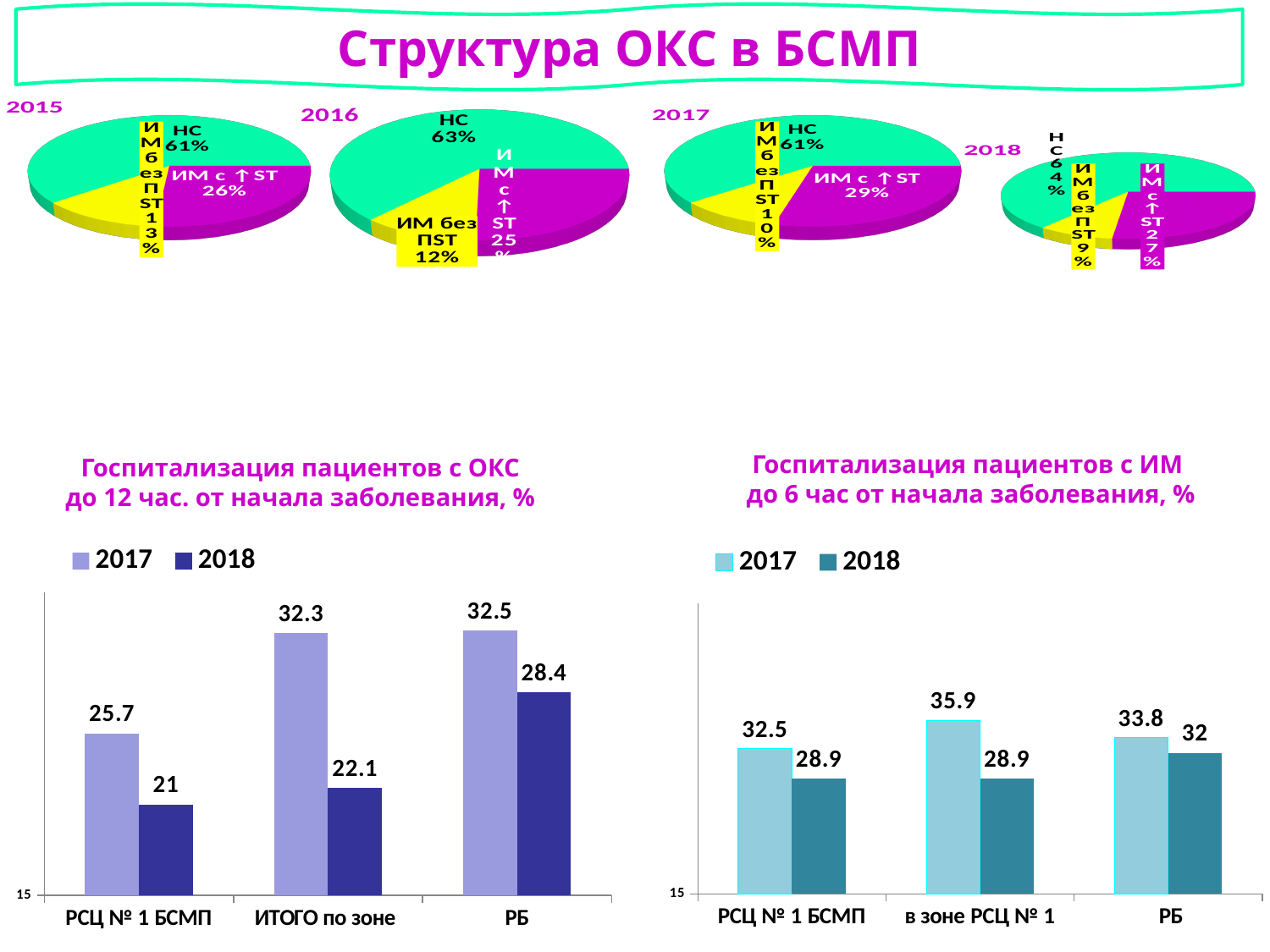
In the chart 'Госпитализация пациентов с ИМ до 6 час от начала заболевания, %', what is the 2017 value for в зоне РСЦ № 1? 35.9 In the 2015 pie chart, what share is labelled for НС? 61% In the 2015 pie chart, which slice is the smallest? ИМ без ПST In the 2018 pie chart, which slice is the largest? НС In the 2016 pie chart, what share is labelled for ИМ без ПST? 12% What type of chart is 'Госпитализация пациентов с ОКС до 12 час. от начала заболевания, %'? Bar chart In the chart 'Госпитализация пациентов с ИМ до 6 час от начала заболевания, %', which is larger: the 2018 value for РБ or the 2018 value for РСЦ № 1 БСМП? РБ In the 2017 pie chart, what share is labelled for ИМ с ↑ST? 29% In the chart 'Госпитализация пациентов с ОКС до 12 час. от начала заболевания, %', what is the difference between the 2017 and 2018 values for ИТОГО по зоне? 10.2 In the chart 'Госпитализация пациентов с ОКС до 12 час. от начала заболевания, %', what is the 2018 value for РСЦ № 1 БСМП? 21 How many series does the legend list in the chart 'Госпитализация пациентов с ИМ до 6 час от начала заболевания, %'? 2 In the chart 'Госпитализация пациентов с ОКС до 12 час. от начала заболевания, %', which category has the highest 2017 value? РБ